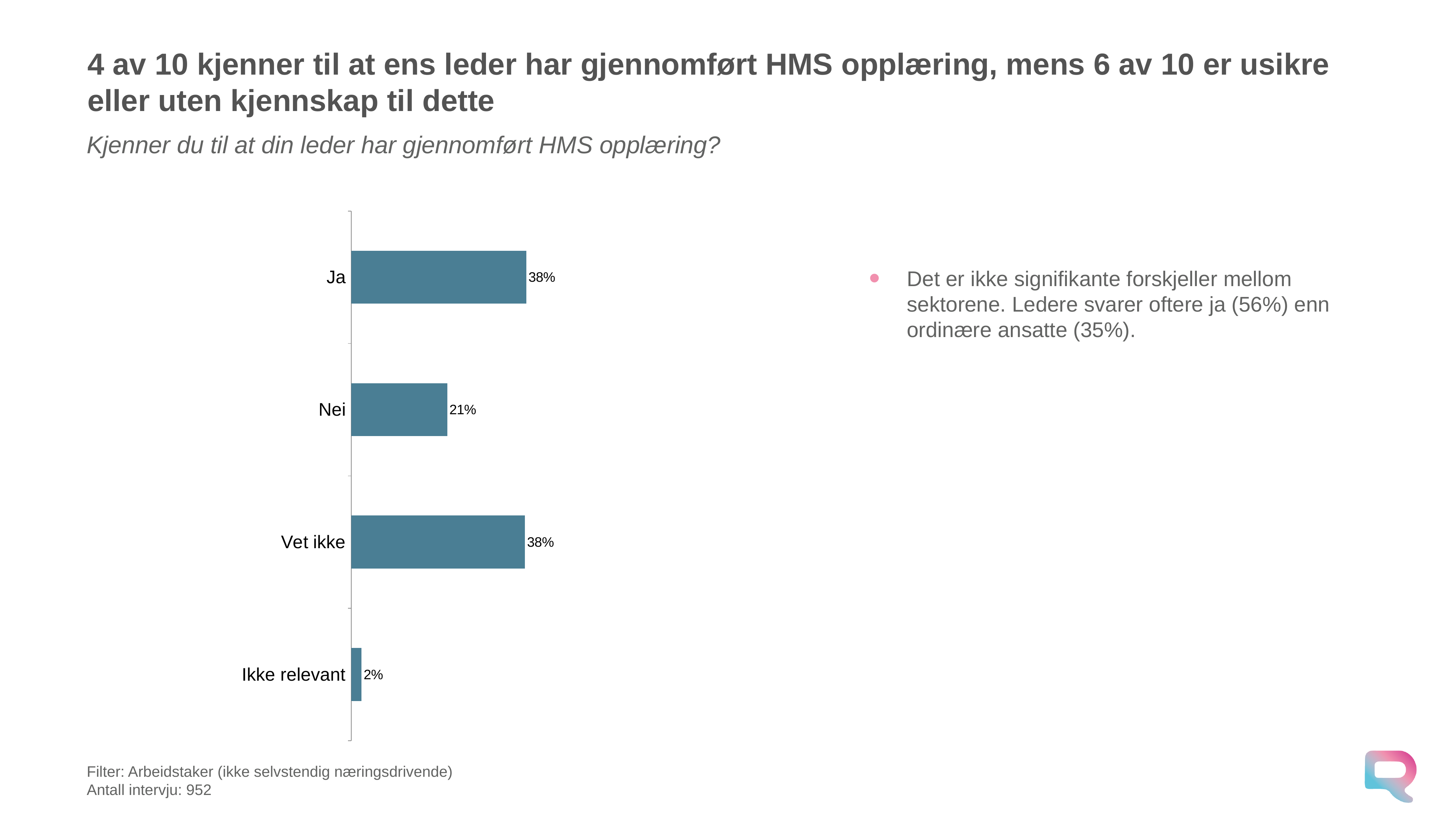
Which category has the lowest value? Ikke relevant What question is the chart based on, as shown in the subtitle? Kjenner du til at din leder har gjennomført HMS opplæring? What is the difference between the values for "Nei" and "Ikke relevant"? 19% What is the value for "Nei"? 21% What is the value for "Ikke relevant"? 2% Which is larger, the value for "Ja" or the value for "Ikke relevant"? Ja Which is larger, the value for "Nei" or the value for "Vet ikke"? Vet ikke What is the value for "Vet ikke"? 38% What kind of chart is shown on the slide? Bar chart What is the difference between the values for "Ja" and "Nei"? 17% What is the value for "Ja"? 38% How many categories are shown in the chart? 4